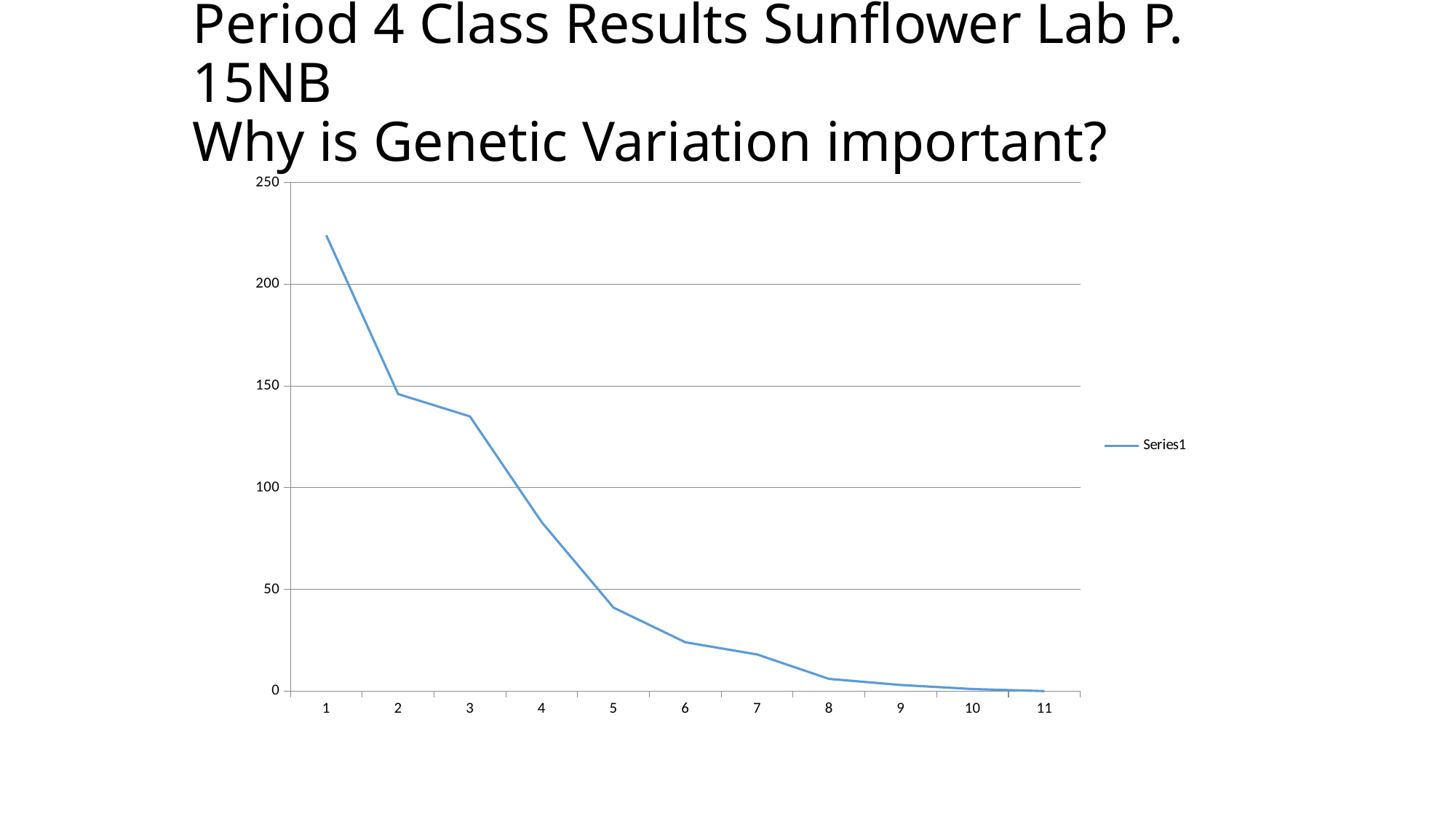
What is the highest value shown on the y axis? 250 Which x-axis category has the highest value? 1 What kind of chart is shown on the slide? line chart Which has the larger value, x = 2 or x = 4? 2 Is the value at x = 1 greater or less than 200? greater Is the value at x = 3 greater or less than 150? less What is the name of the series shown in the legend? Series1 Which x-axis category has the lowest value? 11 How many series does the legend list? 1 Is the value at x = 5 greater or less than 50? less How many points are plotted along the x axis? 11 Do the values rise or fall as you move from 1 to 11 along the x axis? fall